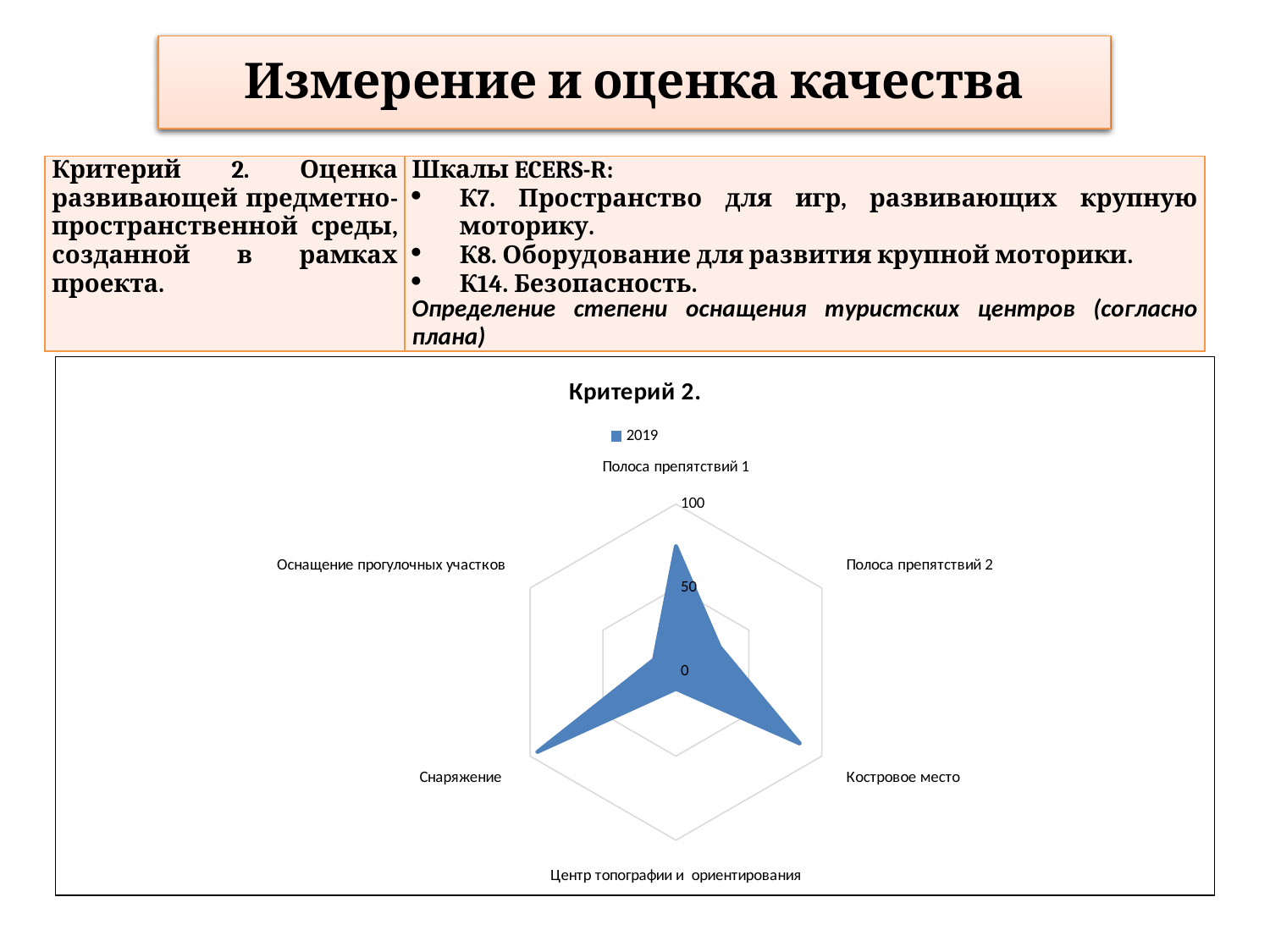
What is the title of the chart? Критерий 2. Is the value for Костровое место greater or less than 50? greater Is the value for Центр топографии и ориентирования greater or less than 50? less Is the value for Снаряжение greater or less than 50? greater What is the legend entry of the chart? 2019 Which has the larger value, Костровое место or Центр топографии и ориентирования? Костровое место Which has the larger value, Снаряжение or Полоса препятствий 2? Снаряжение How many series does the chart legend list? 1 How many categories are plotted on the radar chart? 6 What kind of chart is shown on the slide? radar chart